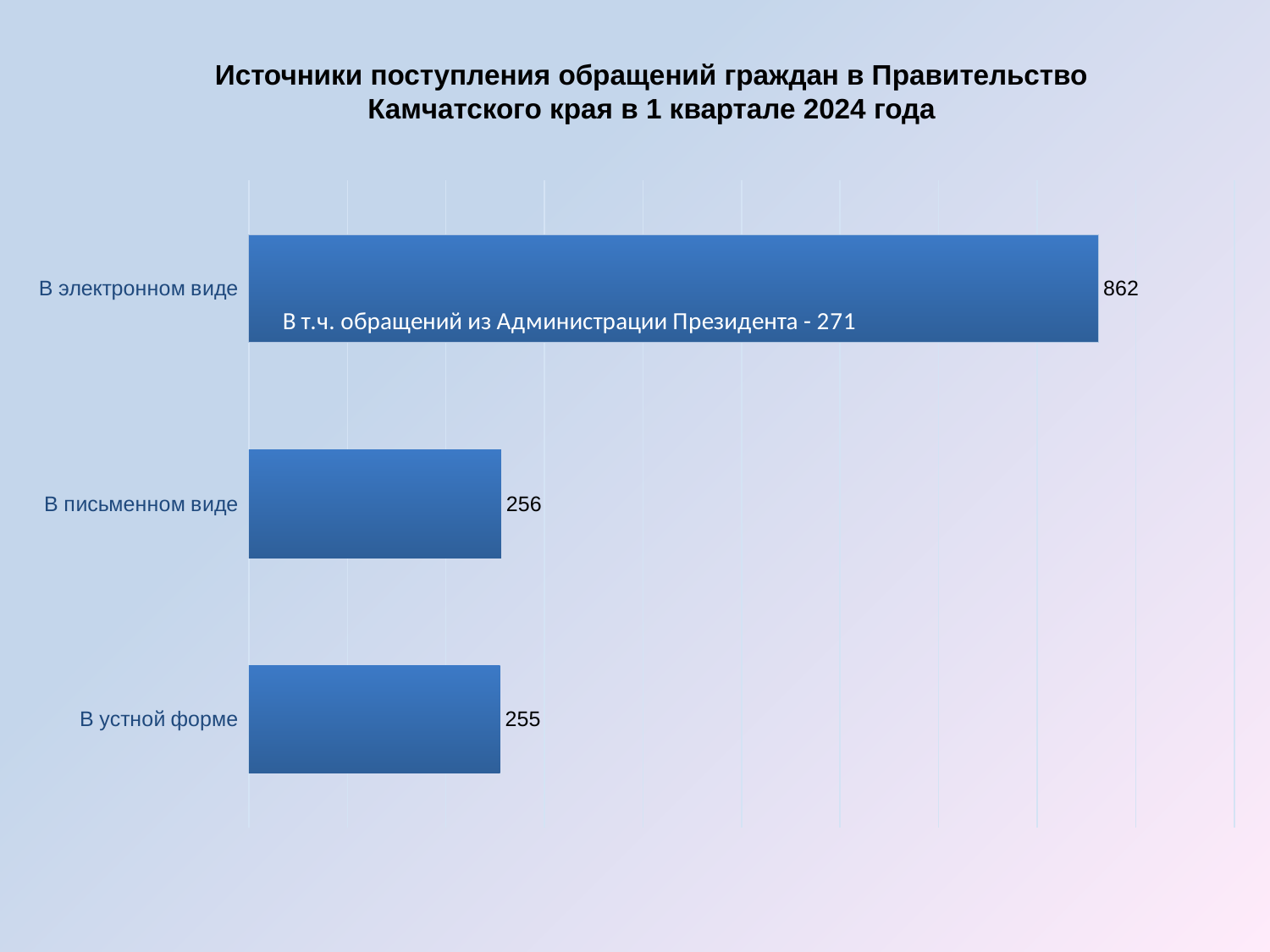
Which is larger, the value for «В электронном виде» or the value for «В устной форме»? В электронном виде What is the difference between the values for «В электронном виде» and «В письменном виде»? 606 What kind of chart is shown on the slide? Bar chart How many categories are shown in the chart? 3 What is the value for «В письменном виде»? 256 What is the title of the chart? Источники поступления обращений граждан в Правительство Камчатского края в 1 квартале 2024 года Which category has the highest value? В электронном виде Which category is listed at the bottom of the chart? В устной форме What is the difference between the values for «В электронном виде» and «В устной форме»? 607 According to the note inside the top bar, how many of the electronic appeals came from the Администрация Президента? 271 What is the value for «В устной форме»? 255 What is the value for «В электронном виде»? 862